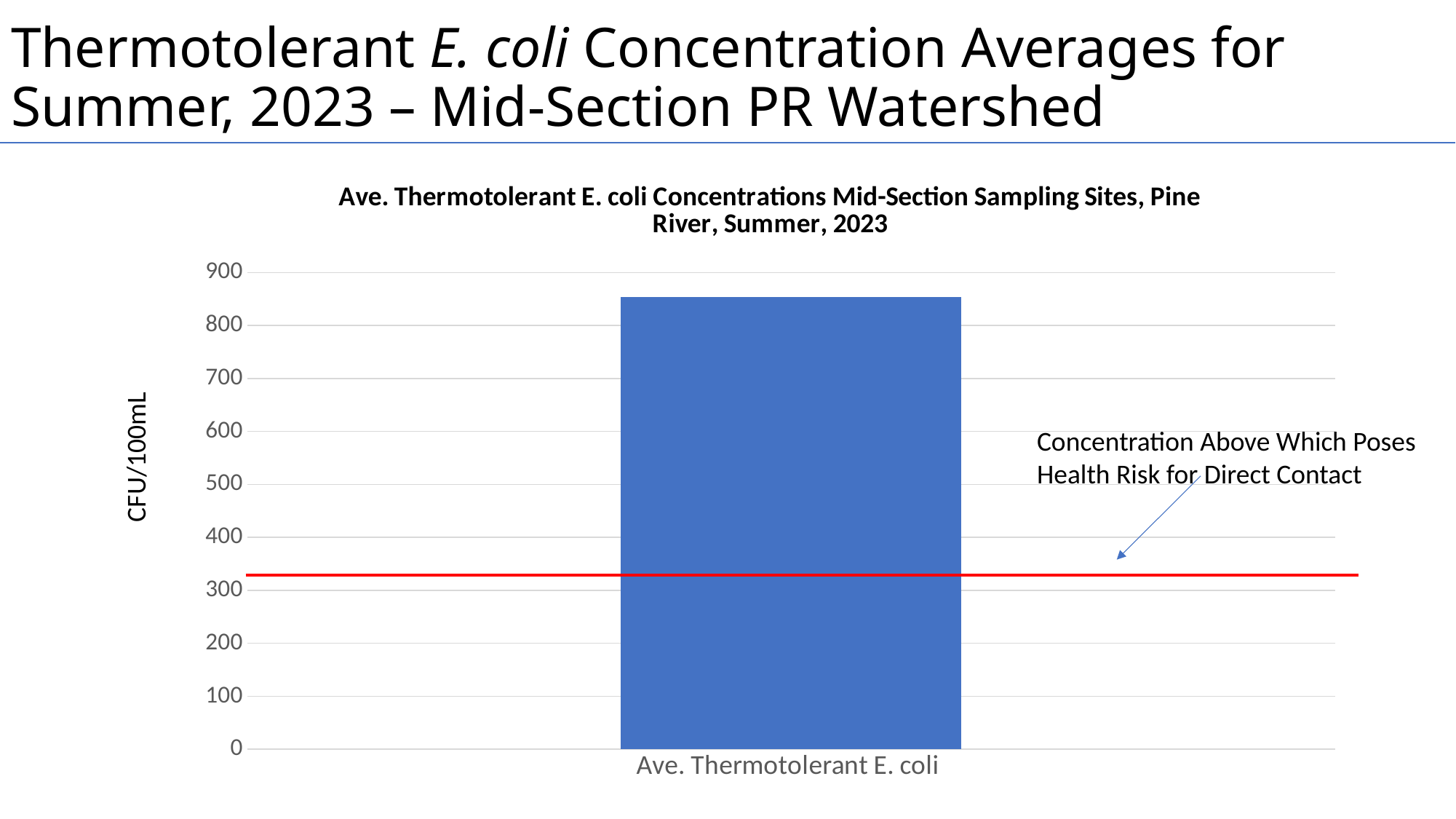
Is the value for Ave. Thermotolerant E. coli greater or less than 900? less What is the label on the vertical axis of the chart? CFU/100mL What kind of chart is shown on the slide? bar chart Is the bar for Ave. Thermotolerant E. coli above or below the red line marking the concentration that poses a health risk for direct contact? above How many bars are plotted in the chart? 1 What is the category label shown under the bar? Ave. Thermotolerant E. coli Is the value for Ave. Thermotolerant E. coli greater or less than 800? greater What is the title of the chart? Ave. Thermotolerant E. coli Concentrations Mid-Section Sampling Sites, Pine River, Summer, 2023 What is the highest value shown on the vertical axis of the chart? 900 Is the value for Ave. Thermotolerant E. coli greater or less than 500? greater